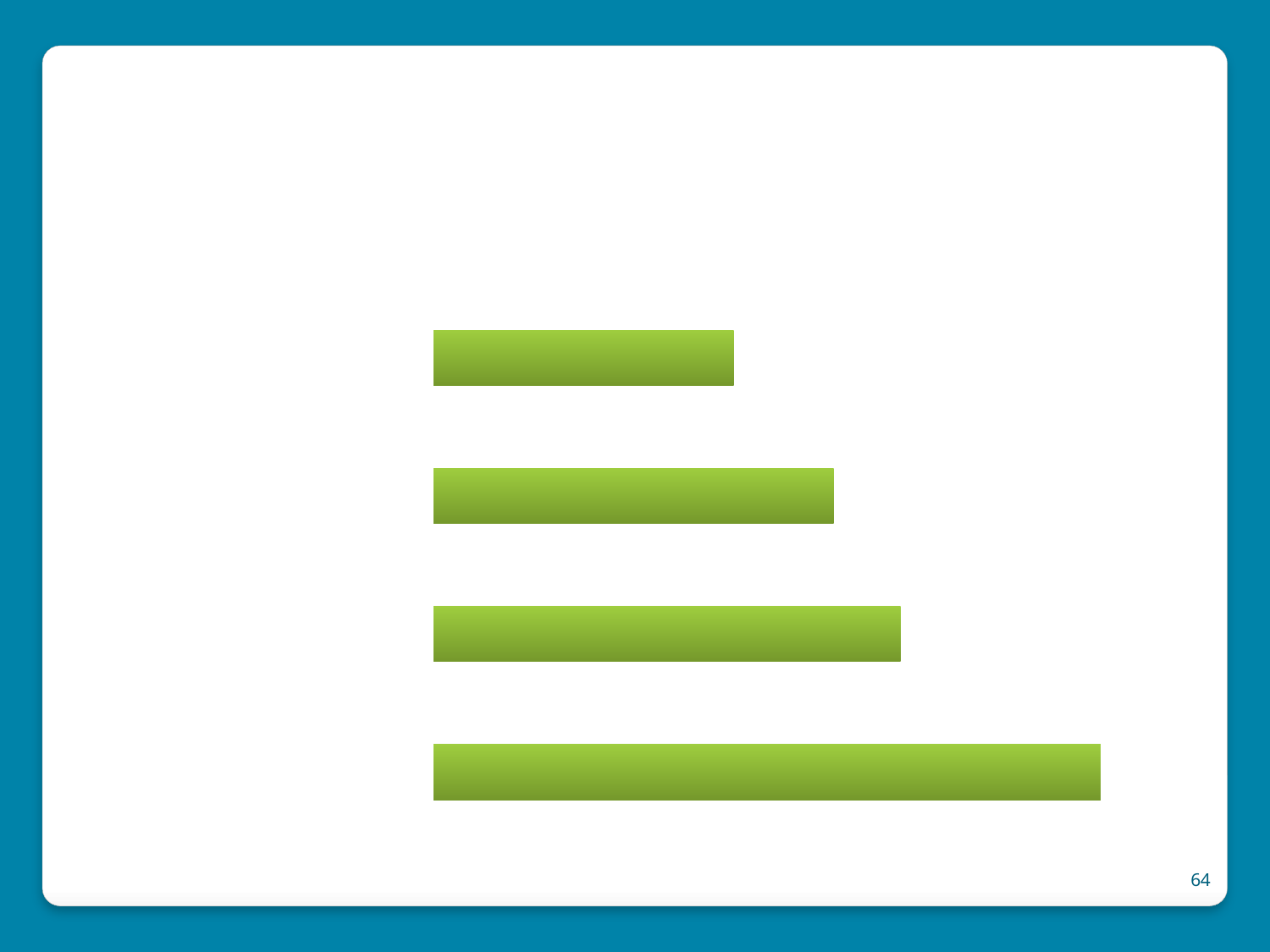
Which is longer, the top bar or the bottom bar? the bottom bar What kind of chart is shown on the slide? bar chart What colour are the bars in the chart? green Do the bars get longer or shorter going from the top of the chart to the bottom? longer Are the bars in the chart horizontal or vertical? horizontal Which bar is the longest: the top, second, third, or bottom bar? the bottom bar Which bar is the shortest: the top, second, third, or bottom bar? the top bar Which is longer, the second bar from the top or the third bar from the top? the third bar from the top How many bars does the chart show? 4